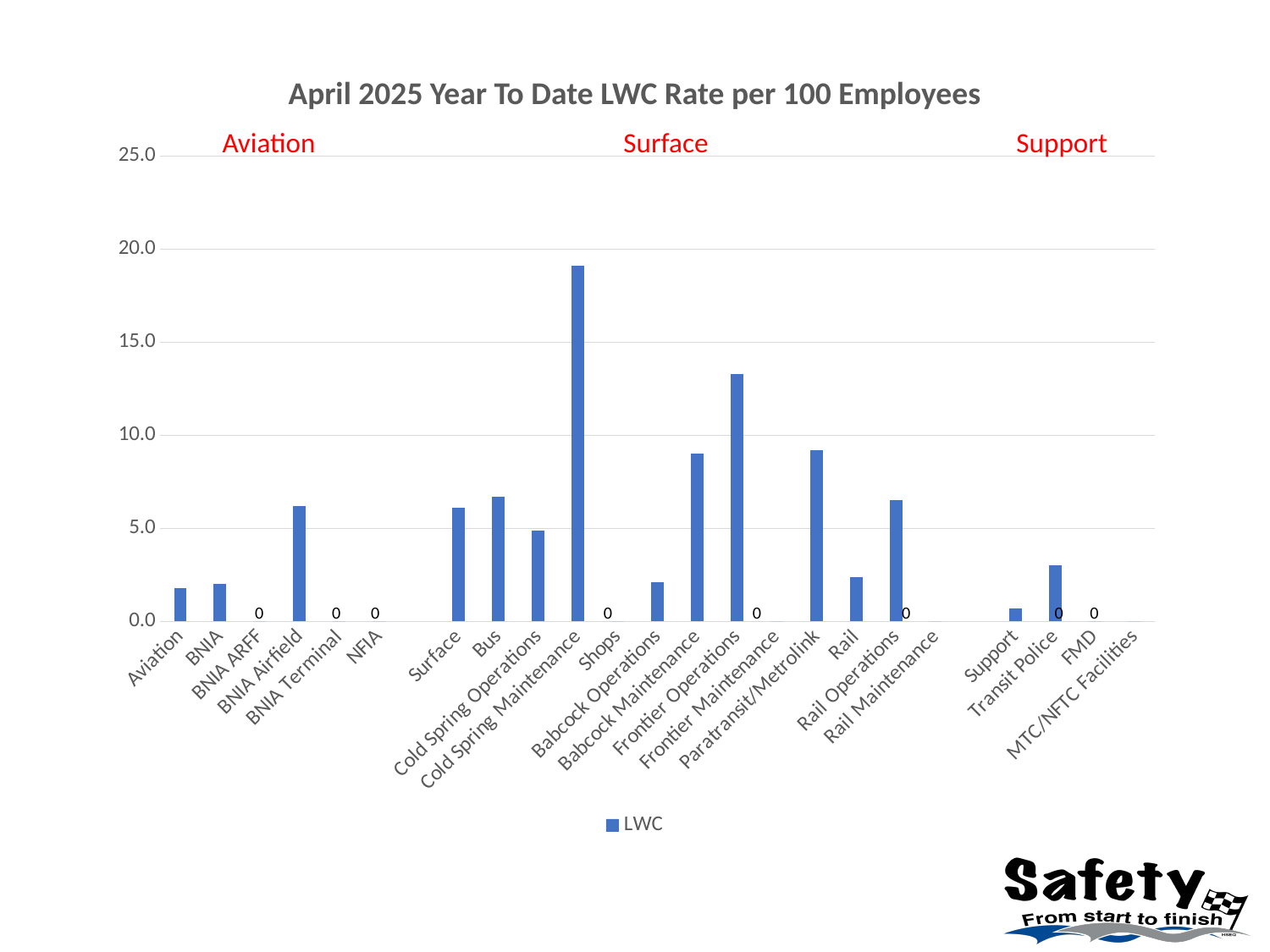
How many series does the legend list? 1 Which category has the highest LWC rate? Cold Spring Maintenance What is the LWC rate for NFIA? 0 Which is larger, the value for Rail or the value for Rail Operations? Rail Operations What is the title of the chart? April 2025 Year To Date LWC Rate per 100 Employees Is the value for Frontier Operations greater or less than 10.0? greater Is the value for Transit Police greater or less than 5.0? less What kind of chart is shown on the slide? bar chart What is the LWC rate for BNIA ARFF? 0 What are the three red group headings shown above the chart? Aviation, Surface, Support Is the value for Cold Spring Maintenance greater or less than 15.0? greater Which is larger, the value for Frontier Operations or the value for Babcock Maintenance? Frontier Operations